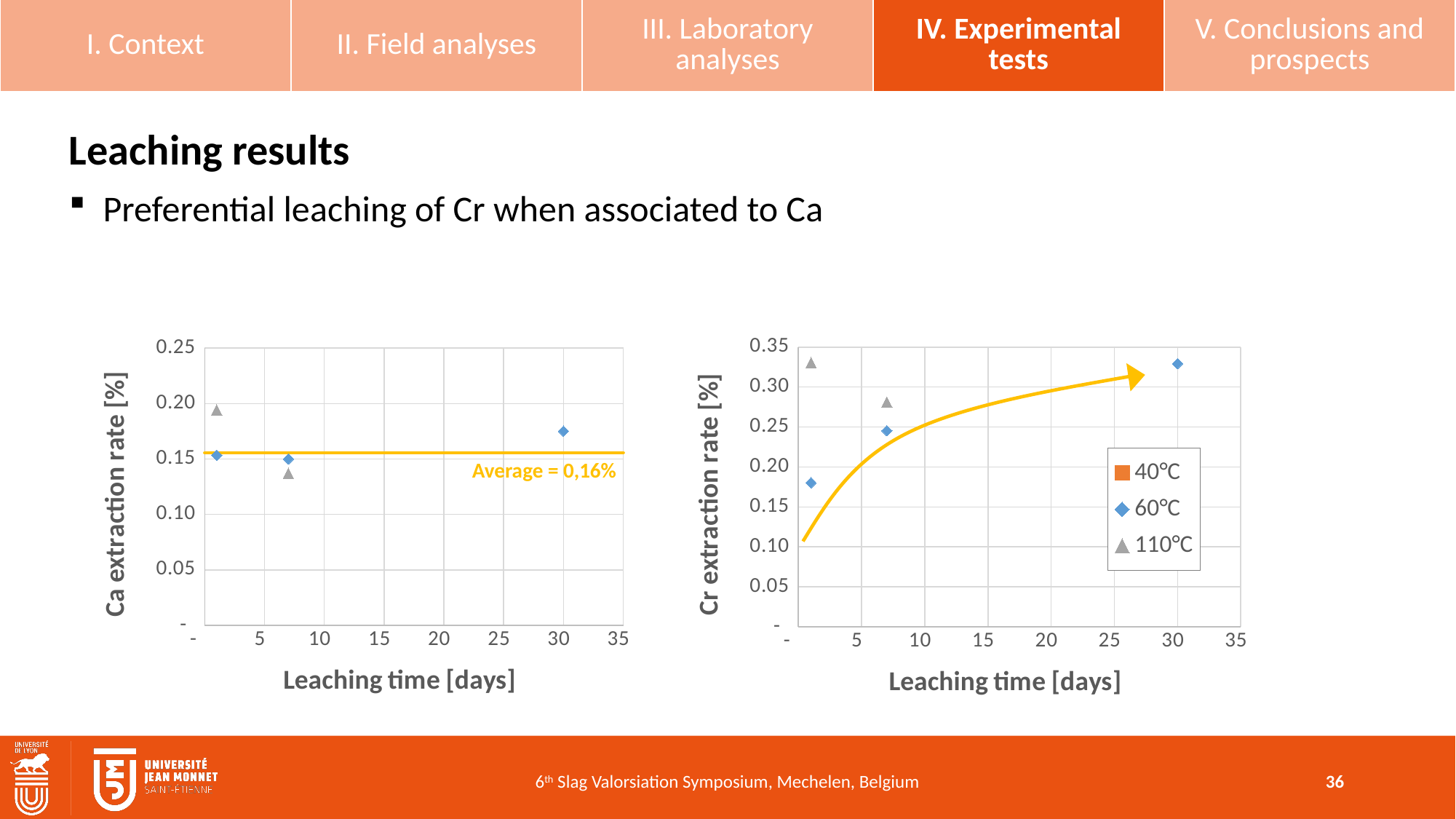
What kind of chart is the left chart (Ca extraction rate)? scatter chart On the right chart (Cr extraction rate), is the 110°C value at the earliest leaching time greater or less than 0.30? greater On the left chart (Ca extraction rate), is the 60°C value at 30 days greater or less than 0.15? greater On the left chart (Ca extraction rate), is the 110°C value at the earliest leaching time greater or less than 0.15? greater How many series does the legend of the right chart (Cr extraction rate) list? 3 On the right chart (Cr extraction rate), does the 60°C series rise or fall as leaching time increases? rises What is the y-axis title of the left chart? Ca extraction rate [%] On the right chart (Cr extraction rate), at around 7 days, which series has the higher value, 60°C or 110°C? 110°C On the right chart (Cr extraction rate), how many 60°C data points are plotted? 3 On the left chart (Ca extraction rate), what average value is labelled on the horizontal line? Average = 0,16%